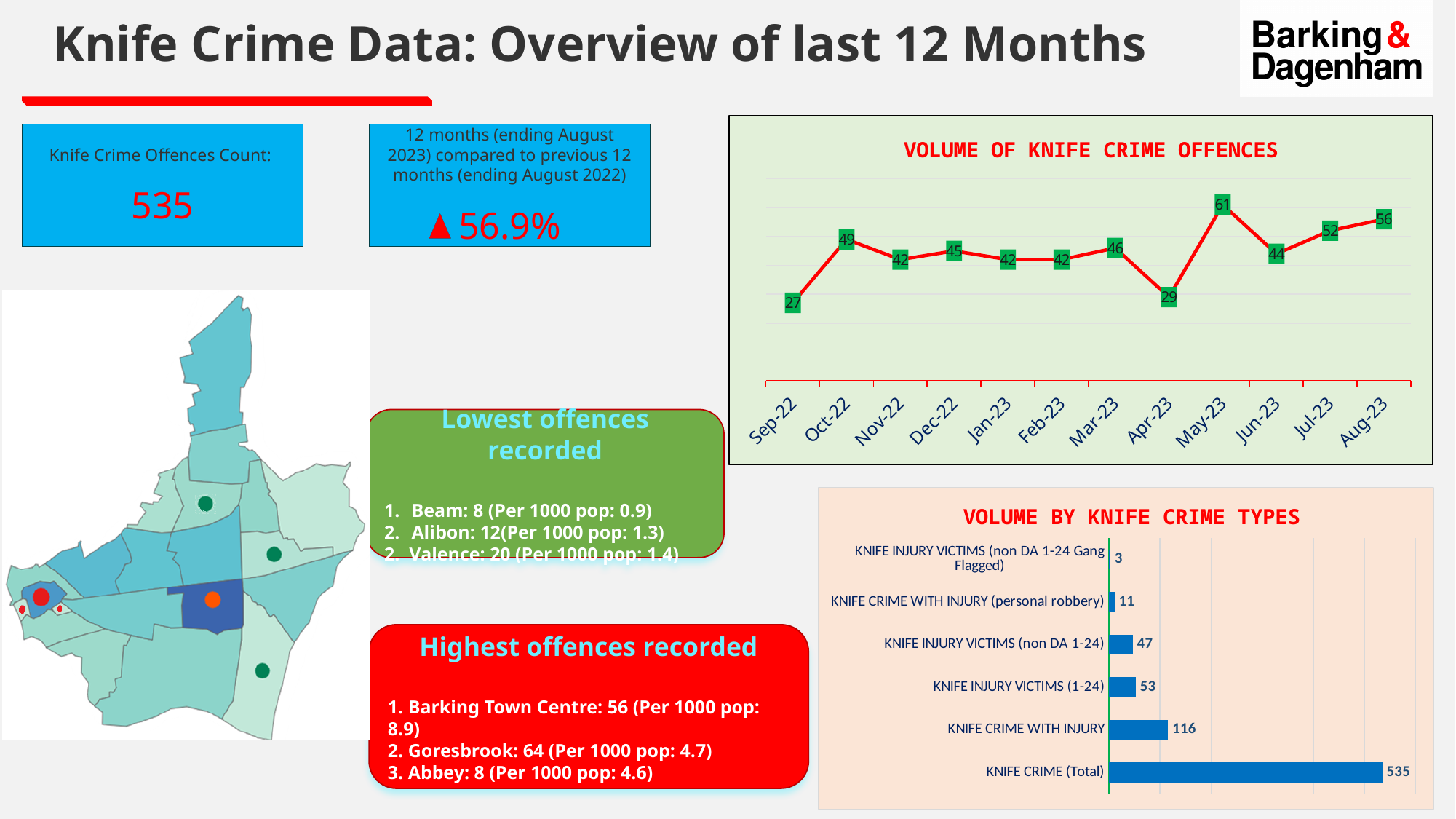
How many categories are shown in the 'VOLUME BY KNIFE CRIME TYPES' chart? 6 In the 'VOLUME OF KNIFE CRIME OFFENCES' chart, what is the difference between the values for May-23 and Apr-23? 32 In the 'VOLUME BY KNIFE CRIME TYPES' chart, which category has the lowest value? KNIFE INJURY VICTIMS (non DA 1-24 Gang Flagged) How many months are plotted in the 'VOLUME OF KNIFE CRIME OFFENCES' chart? 12 In the 'VOLUME OF KNIFE CRIME OFFENCES' chart, which month has the lowest value? Sep-22 What kind of chart is 'VOLUME BY KNIFE CRIME TYPES'? Bar chart In the 'VOLUME OF KNIFE CRIME OFFENCES' chart, which is larger, the value for Oct-22 or the value for Jul-23? Jul-23 In the 'VOLUME BY KNIFE CRIME TYPES' chart, what is the value for KNIFE CRIME WITH INJURY? 116 In the 'VOLUME BY KNIFE CRIME TYPES' chart, what is the difference between KNIFE INJURY VICTIMS (1-24) and KNIFE INJURY VICTIMS (non DA 1-24)? 6 What kind of chart is 'VOLUME OF KNIFE CRIME OFFENCES'? Line chart In the 'VOLUME OF KNIFE CRIME OFFENCES' chart, what is the value for Sep-22? 27 In the 'VOLUME OF KNIFE CRIME OFFENCES' chart, which month has the highest value? May-23